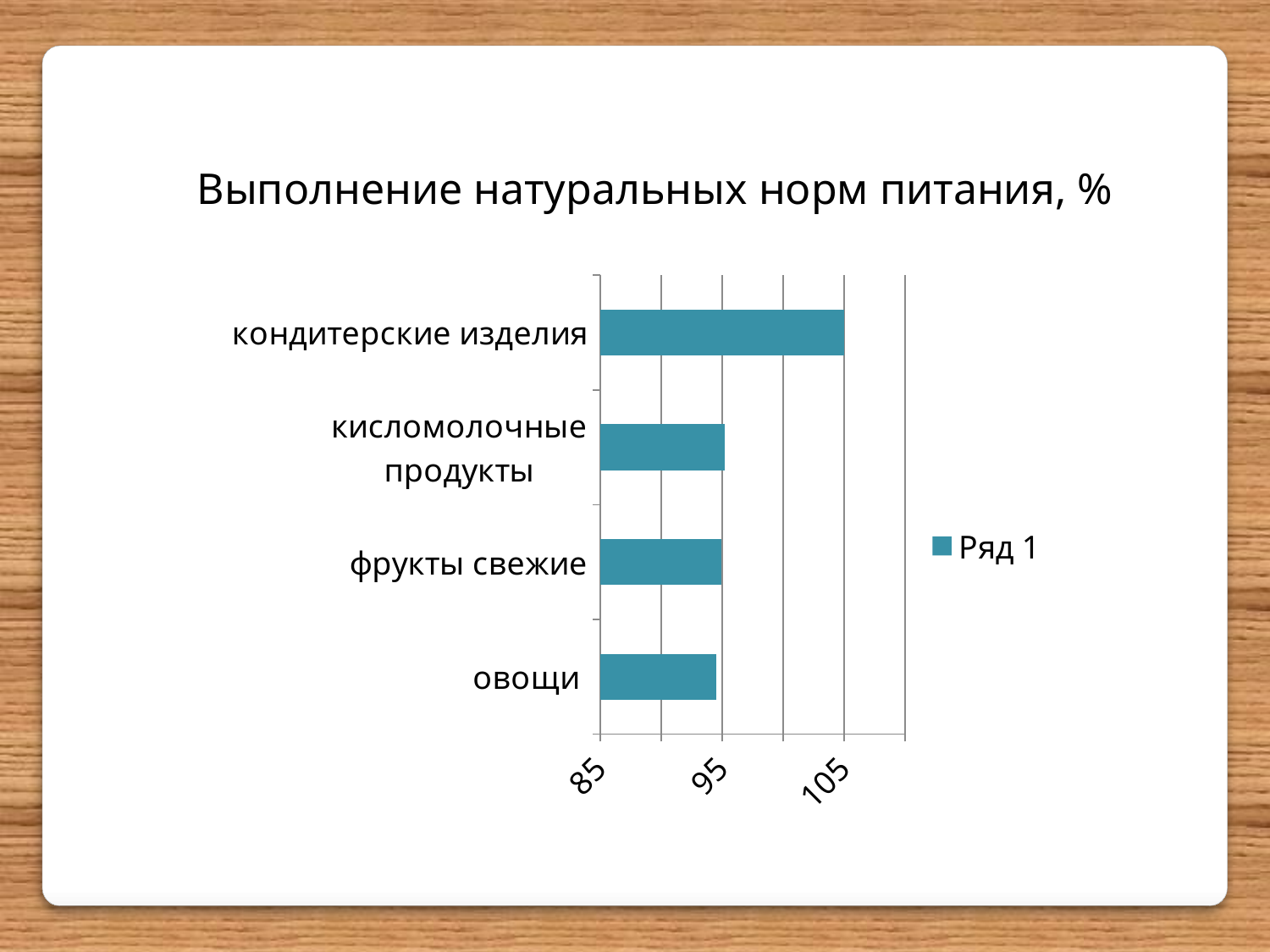
What is the name of the series in the legend? Ряд 1 Which category has the highest value? кондитерские изделия Is the value for фрукты свежие greater or less than 85? greater What is the title of the chart? Выполнение натуральных норм питания, % What is the value for кондитерские изделия? 105 Is the value for овощи greater or less than 105? less Is the value for кисломолочные продукты greater or less than 105? less Which is larger, the value for кондитерские изделия or the value for овощи? кондитерские изделия How many series does the legend list? 1 How many categories are shown in the chart? 4 What type of chart is shown on the slide? bar chart